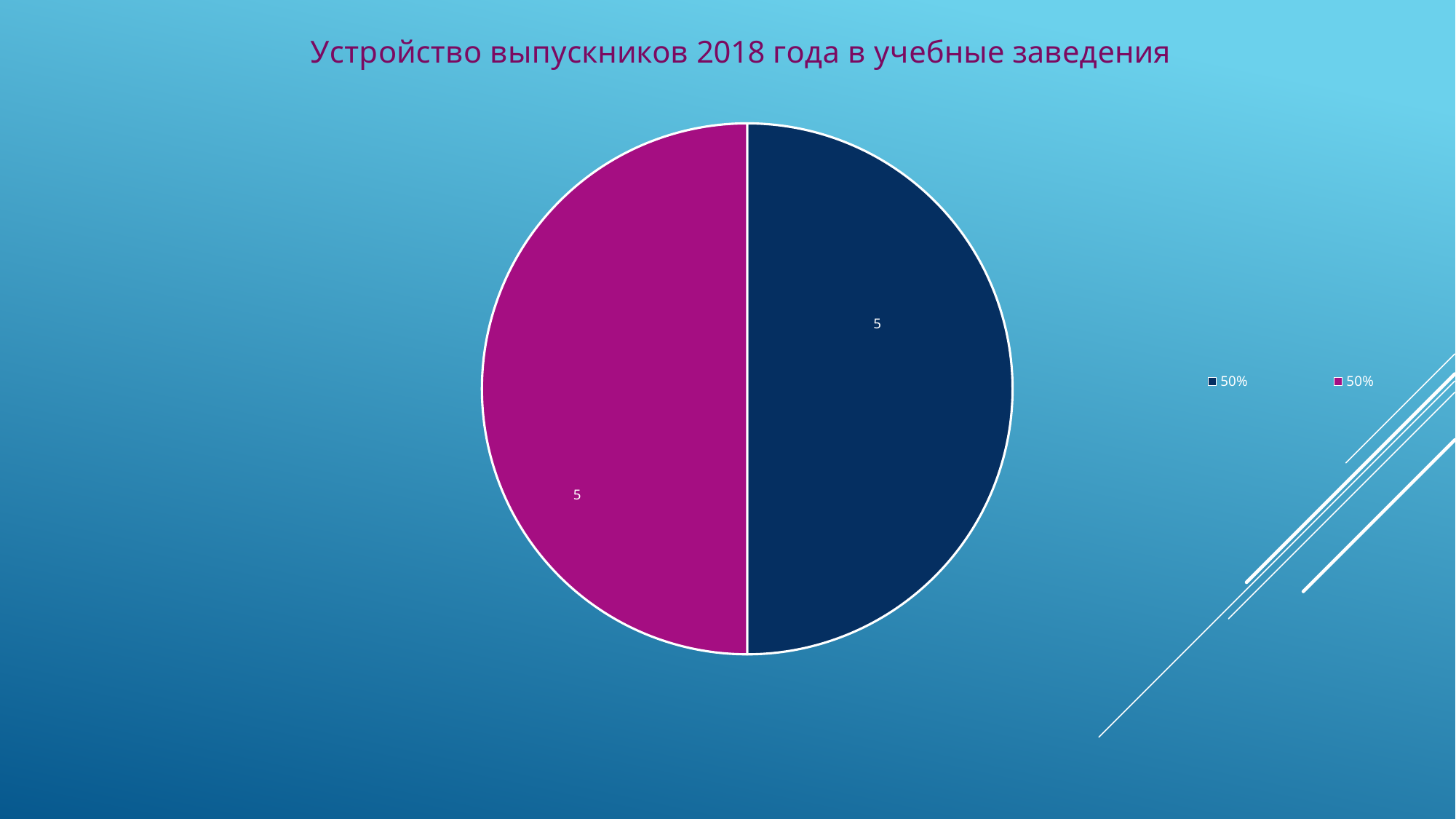
What kind of chart is shown on the slide? pie chart How many slices does the pie chart have? 2 What text is shown for the two legend entries of the pie chart? 50% and 50% How many entries does the legend of the pie chart list? 2 What share of the pie does the magenta slice represent? 50% What is the title of the chart on the slide? Устройство выпускников 2018 года в учебные заведения What is the total of the values printed on the two slices of the pie chart? 10 What value is printed on the dark blue slice of the pie chart? 5 What is the difference between the values printed on the dark blue slice and the magenta slice? 0 What share of the pie does the dark blue slice represent? 50% What value is printed on the magenta slice of the pie chart? 5